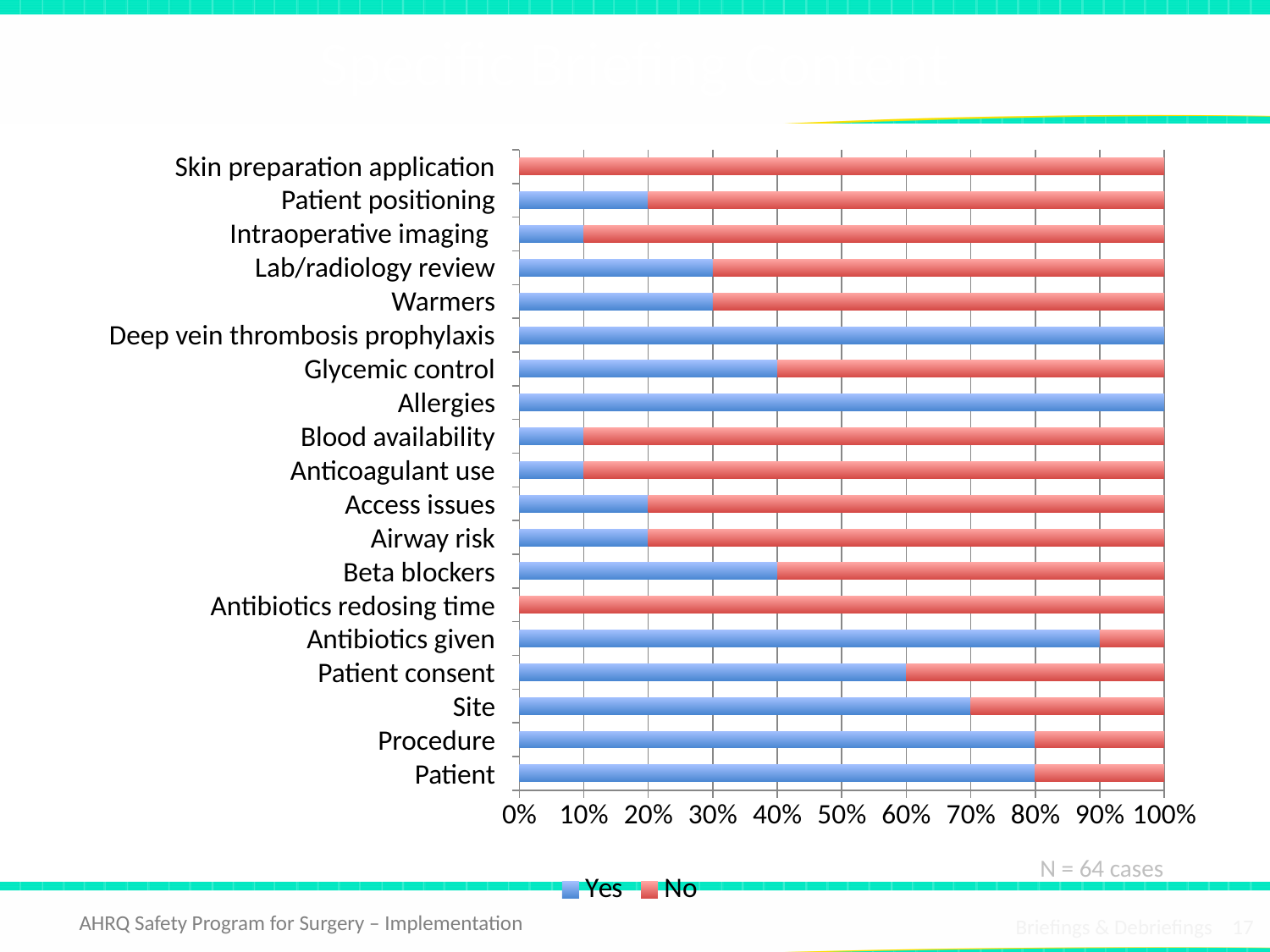
How many categories are plotted on the chart? 19 What kind of chart is shown on the slide? bar chart What is the Yes value for Antibiotics given? 90% What is the Yes value for Site? 70% Which categories have a Yes value of 100%? Deep vein thrombosis prophylaxis and Allergies Is the Yes value for Beta blockers greater or less than 50%? less How many series does the legend list? 2 What is the Yes value for Patient consent? 60% Which categories have a Yes value of 0%? Skin preparation application and Antibiotics redosing time What is the No value for Patient? 20% Which has a larger Yes value, Glycemic control or Warmers? Glycemic control What is the difference between the Yes values for Antibiotics given and Patient consent? 30%